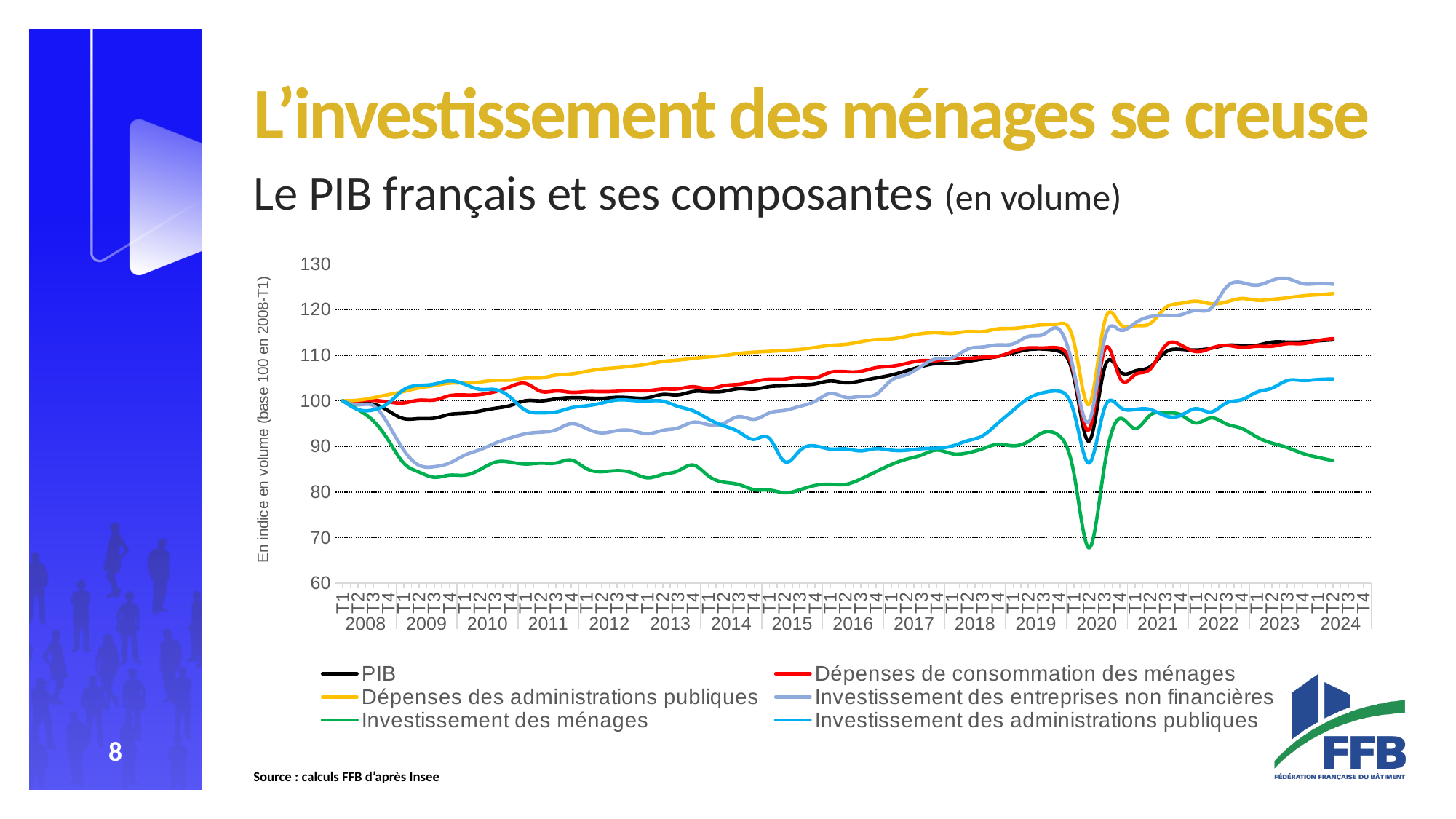
Is the value for Investissement des ménages at the end of the series in 2024 greater or less than 90? less What kind of chart is shown on the slide? line chart Does Investissement des ménages rise or fall between 2022 and 2024? fall Is the value for Investissement des ménages in 2020 T2 greater or less than 70? less What is the title of the chart? Le PIB français et ses composantes (en volume) At the end of the chart in 2024, which is higher: PIB or Investissement des ménages? PIB Is the value for PIB in 2024 greater or less than 110? greater Which series is the lowest in 2015? Investissement des ménages Which series reaches the lowest value in 2020 T2? Investissement des ménages Which series is drawn in green? Investissement des ménages How many series does the legend list? 6